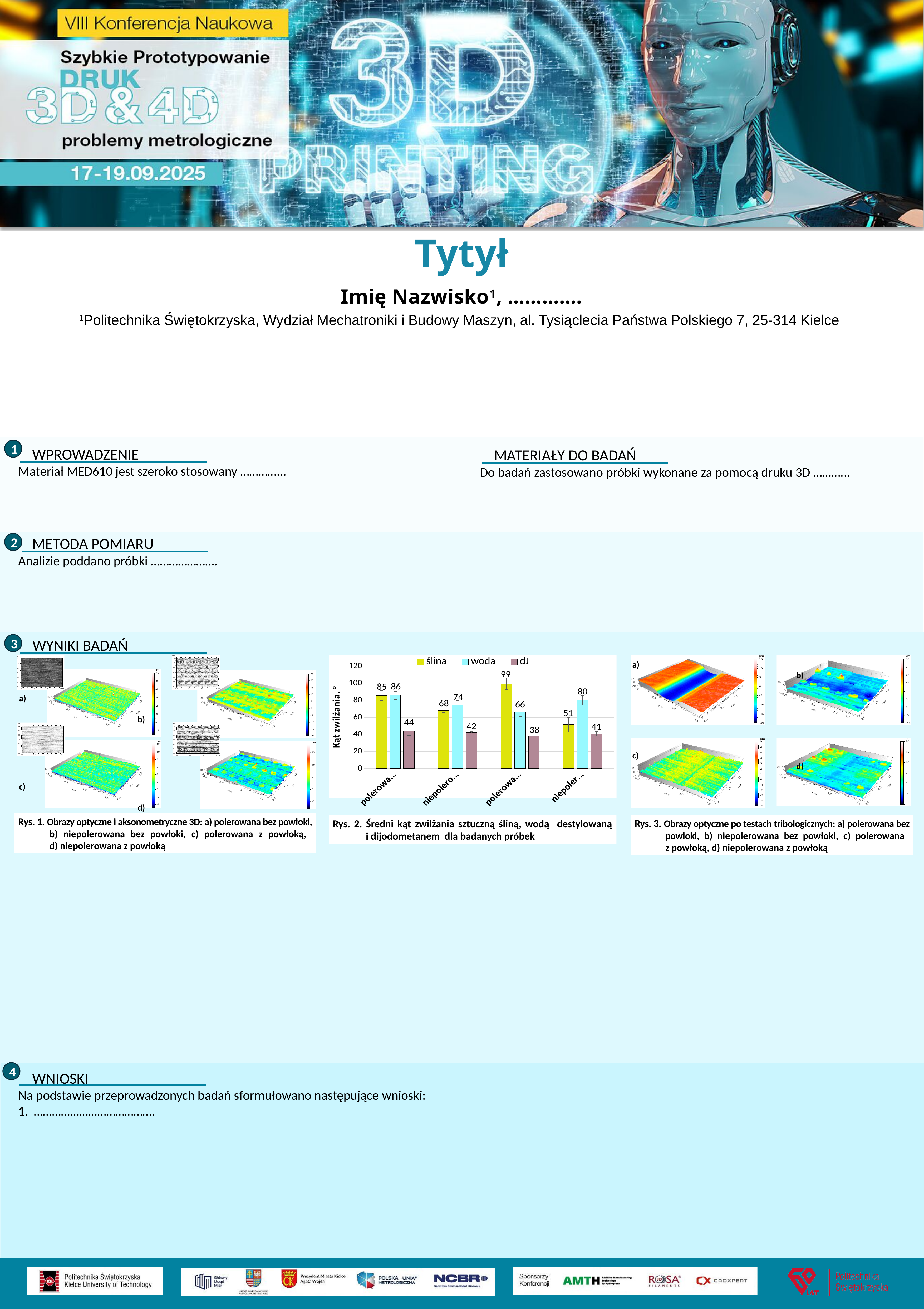
What kind of chart is shown in Rys. 2? bar chart In the Rys. 2 chart, what is the value of the woda bar in the fourth group of bars? 80 In the Rys. 2 chart, what is the difference between the ślina and woda values in the third group of bars? 33 How many groups of bars are plotted along the x axis of the Rys. 2 chart? 4 In the Rys. 2 chart, is the dJ value in the first group of bars greater or less than 60? less In the Rys. 2 chart, what is the lowest value among the dJ bars? 38 What is the y-axis label of the Rys. 2 chart? Kąt zwilżania, ° In the Rys. 2 chart, what is the value of the ślina bar in the first group of bars? 85 How many series does the legend of the Rys. 2 chart list? 3 In the Rys. 2 chart, what is the highest value among the ślina bars? 99 In the Rys. 2 chart, which is larger in the fourth group of bars: the ślina value or the woda value? woda In the Rys. 2 chart, what is the value of the dJ bar in the second group of bars? 42